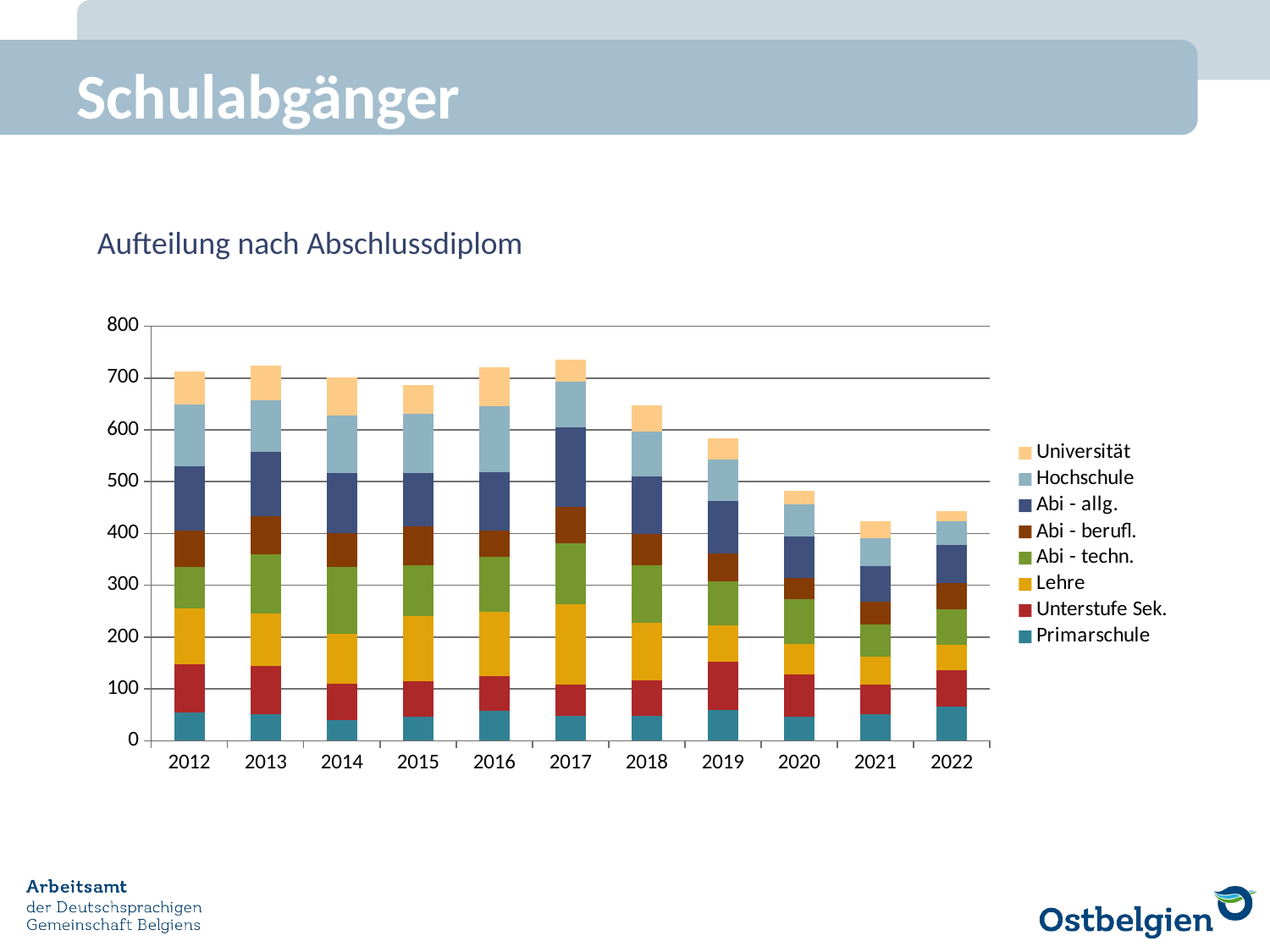
How many series does the legend list? 8 How many years are shown on the x axis? 11 Do the total bar heights generally rise or fall from 2012 to 2022? fall Is the total for 2018 greater or less than 600? greater What is the subtitle of the chart? Aufteilung nach Abschlussdiplom Which year has the lowest total bar? 2021 Which series is listed first (at the top) in the legend? Universität Which total is larger, 2012 or 2022? 2012 Is the total for 2020 greater or less than 500? less What kind of chart is shown on the slide? Stacked bar chart Is the total for 2019 greater or less than 600? less